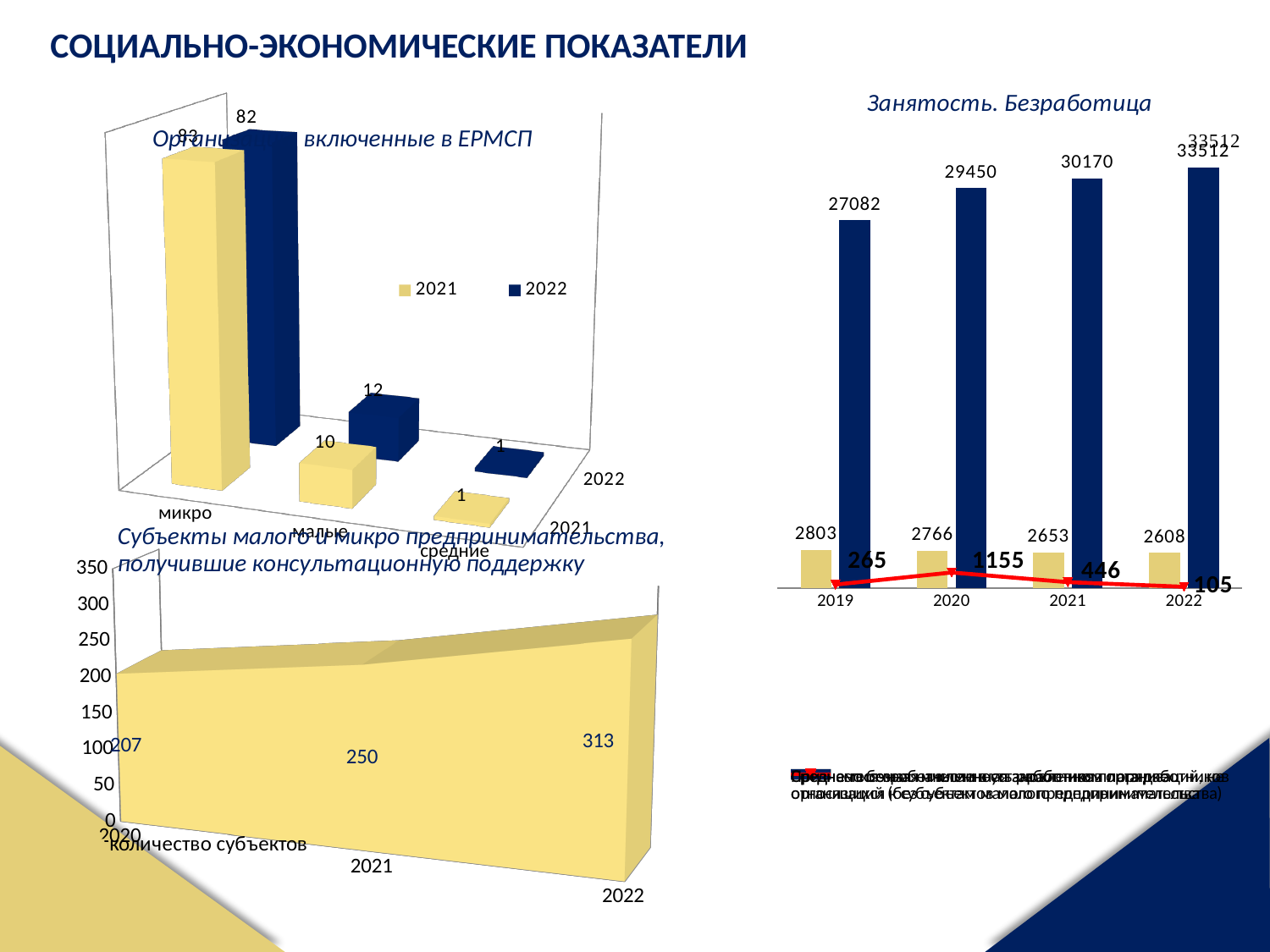
In the chart 'Субъекты малого и микро предпринимательства, получившие консультационную поддержку', what is the value for 2022? 313 In the chart 'Занятость. Безработица', what is the value of the yellow bar for 2019? 2803 In the chart 'Занятость. Безработица', do the yellow bar values rise or fall from 2019 to 2022? fall In the chart 'Занятость. Безработица', in which year does the red line reach its highest value? 2020 In the chart 'Занятость. Безработица', what is the difference between the dark blue bar values for 2022 and 2019? 6430 In the chart 'Занятость. Безработица', what is the value of the tall dark blue bar for 2022? 33512 In the chart 'Субъекты малого и микро предпринимательства, получившие консультационную поддержку', do the values rise or fall from 2020 to 2022? rise In the top-left chart of organisations included in ЕРМСП, what is the 2022 value for 'малые'? 12 In the chart 'Занятость. Безработица', what is the value of the red line point for 2020? 1155 In the chart 'Субъекты малого и микро предпринимательства, получившие консультационную поддержку', what is the difference between the 2022 and 2020 values? 106 In the chart 'Занятость. Безработица', in which year is the red line value lowest? 2022 In the top-left chart of organisations included in ЕРМСП, how many series does the legend list? 2